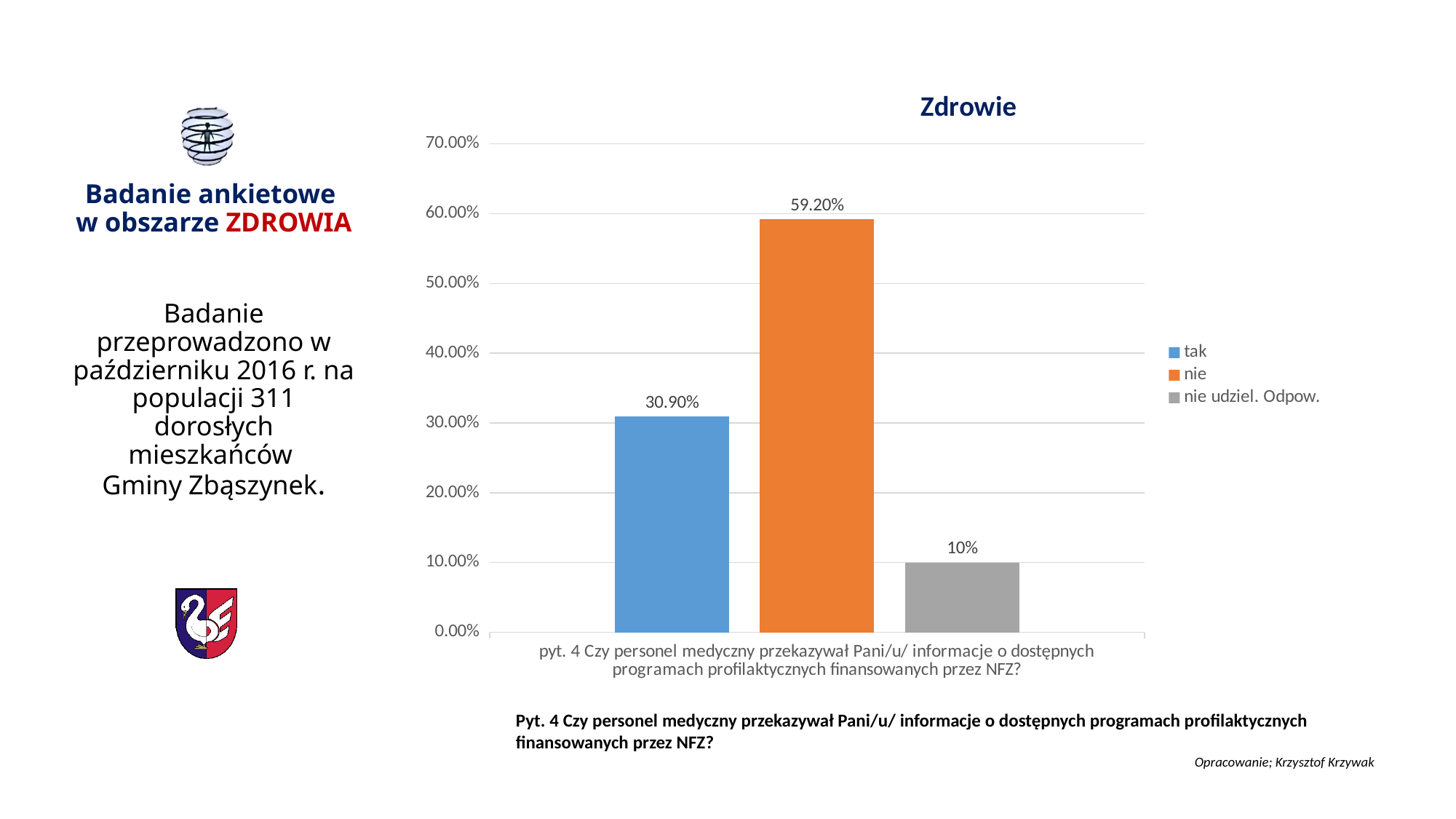
What kind of chart is shown on the slide? bar chart Which series has the lowest value? nie udziel. Odpow. Which is larger, the value for "tak" or the value for "nie udziel. Odpow."? tak Is the value for "nie" greater or less than 50.00%? greater What is the value for "nie"? 59.20% What is the title of the chart? Zdrowie What is the value for "nie udziel. Odpow."? 10% What is the difference between the values for "nie" and "tak"? 28.30% How many series does the legend list? 3 What is the value for "tak"? 30.90% Which series has the highest value? nie What colour is the bar for "nie"? orange